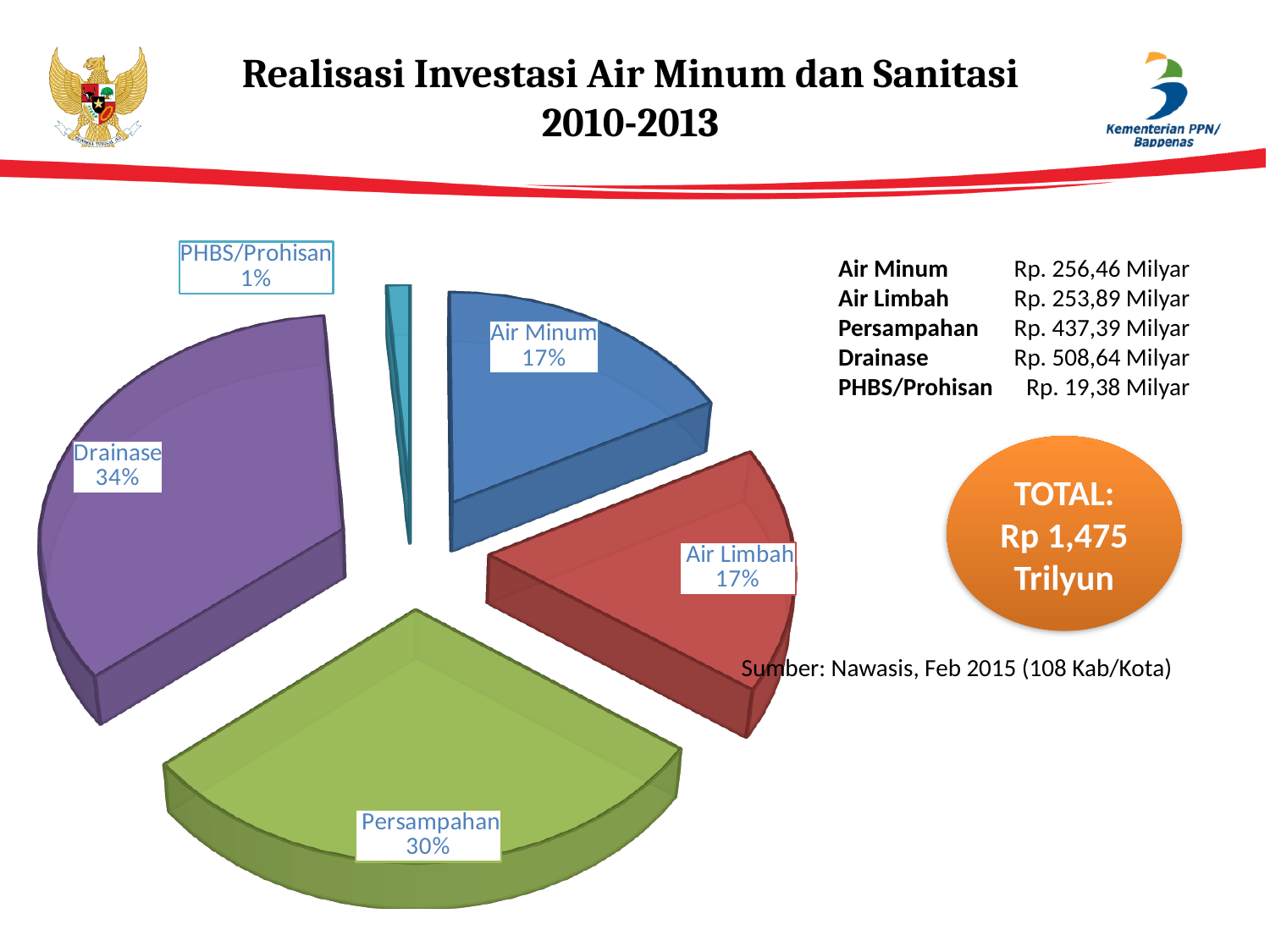
How many slices does the pie chart have? 5 What share of the pie does Drainase represent? 34% What is the title of the slide containing the pie chart? Realisasi Investasi Air Minum dan Sanitasi 2010-2013 What percentage is shown for Air Minum? 17% Which category has the largest slice of the pie? Drainase What share of the pie does Persampahan represent? 30% What percentage is shown for PHBS/Prohisan? 1% What kind of chart is shown on the slide? Pie chart By how many percentage points does Drainase exceed Persampahan? 4 percentage points Which category has the smallest slice of the pie? PHBS/Prohisan Which is larger, the share for Persampahan or the share for Air Limbah? Persampahan What colour is the Persampahan slice of the pie? Green